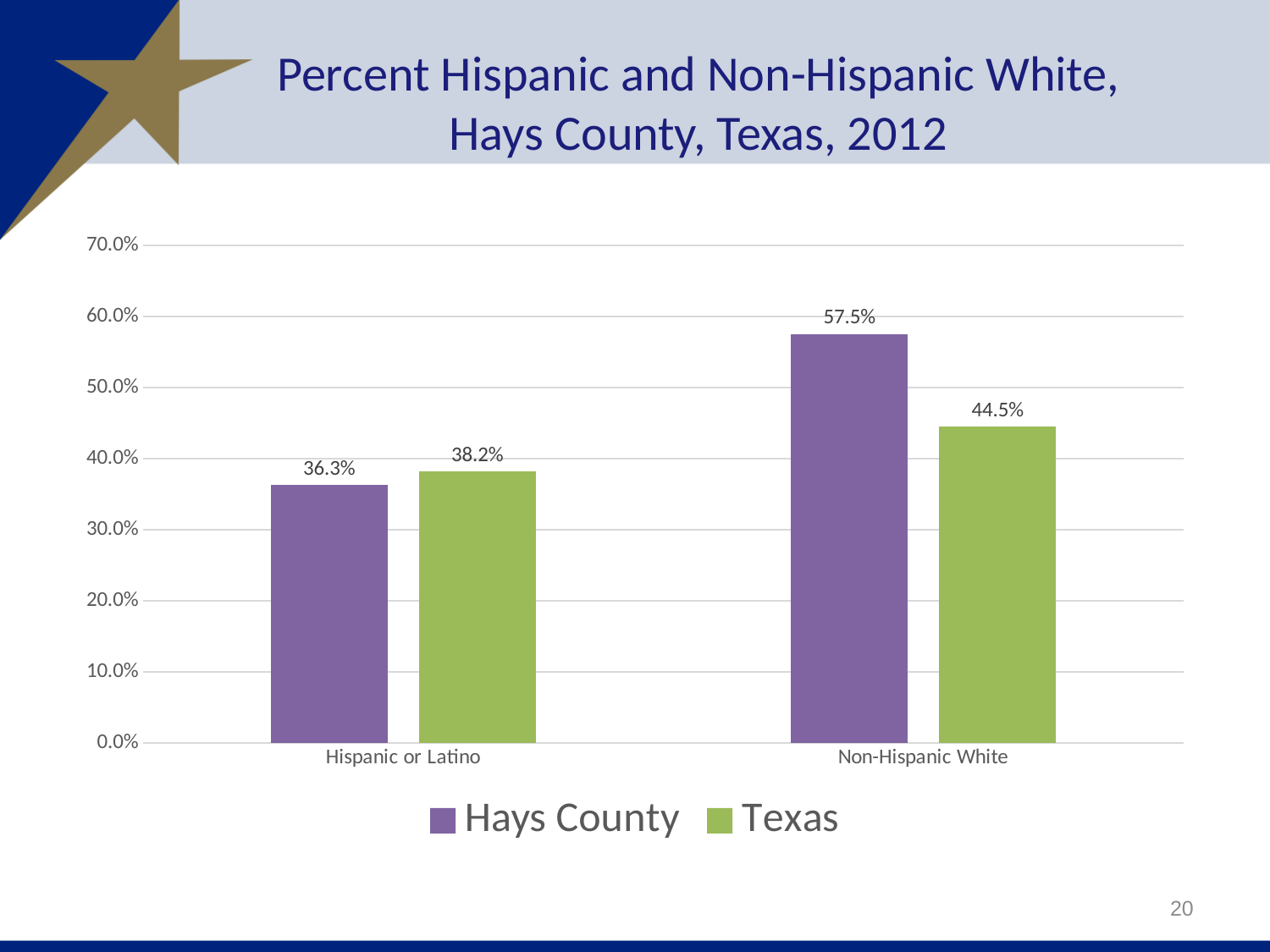
What is the Hays County value for Non-Hispanic White? 57.5% What is the Texas value for Hispanic or Latino? 38.2% For Hispanic or Latino, which is larger: Hays County or Texas? Texas What is the difference between the Hays County and Texas values for Non-Hispanic White? 13.0% How many series does the legend list? 2 Which bar has the lowest value on the chart? Hays County, Hispanic or Latino What is the Hays County value for Hispanic or Latino? 36.3% Which colour represents Texas in the legend? Green How many categories are shown on the x axis? 2 Which bar has the highest value on the chart? Hays County, Non-Hispanic White What is the Texas value for Non-Hispanic White? 44.5% What kind of chart is shown on the slide? Bar chart